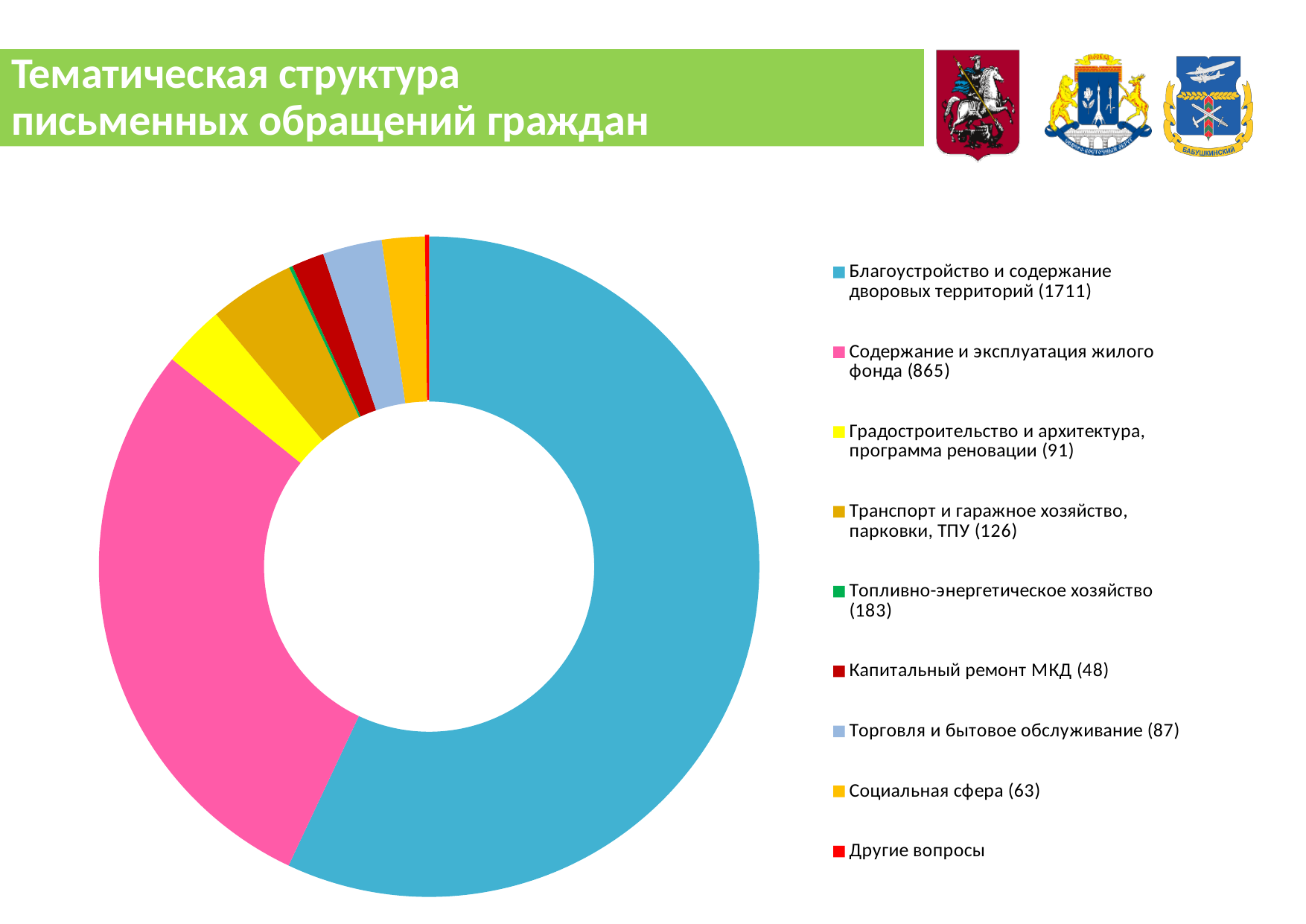
What is the value for «Содержание и эксплуатация жилого фонда»? 865 What is the difference between the values for «Благоустройство и содержание дворовых территорий» and «Содержание и эксплуатация жилого фонда»? 846 What kind of chart is shown on the slide? Pie (donut) chart What is the value for «Капитальный ремонт МКД»? 48 What is the value for «Транспорт и гаражное хозяйство, парковки, ТПУ»? 126 Which is larger: «Содержание и эксплуатация жилого фонда» or «Градостроительство и архитектура, программа реновации»? Содержание и эксплуатация жилого фонда What is the value for «Социальная сфера»? 63 How many categories does the legend of the chart list? 9 Which category has the largest slice in the chart? Благоустройство и содержание дворовых территорий What is the value for «Благоустройство и содержание дворовых территорий»? 1711 What is the title of the slide containing the chart? Тематическая структура письменных обращений граждан What is the value for «Торговля и бытовое обслуживание»? 87